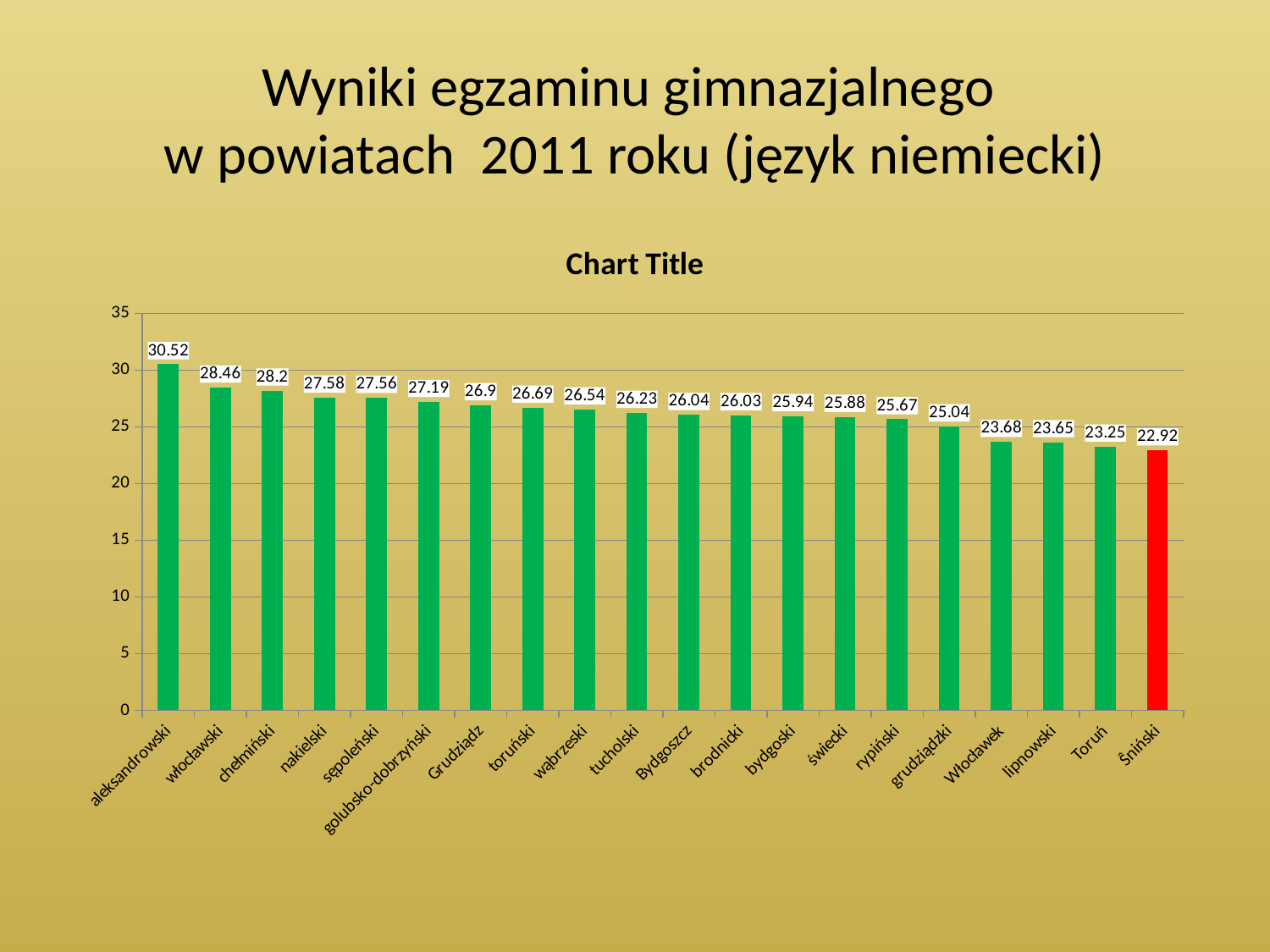
Which is larger, the value for nakielski or the value for lipnowski? nakielski What kind of chart is shown on the slide? bar chart What is the value for Toruń? 23.25 What is the difference between the values for aleksandrowski and żniński? 7.6 What is the value for Grudziądz? 26.9 What is the value for aleksandrowski? 30.52 What is the difference between the values for włocławski and Włocławek? 4.78 Which category has the lowest value? Ŝniński How many categories are shown on the x axis? 20 Which bar is coloured red instead of green? Ŝniński Which category has the highest value? aleksandrowski Is the value for grudziądzki greater or less than 25? greater